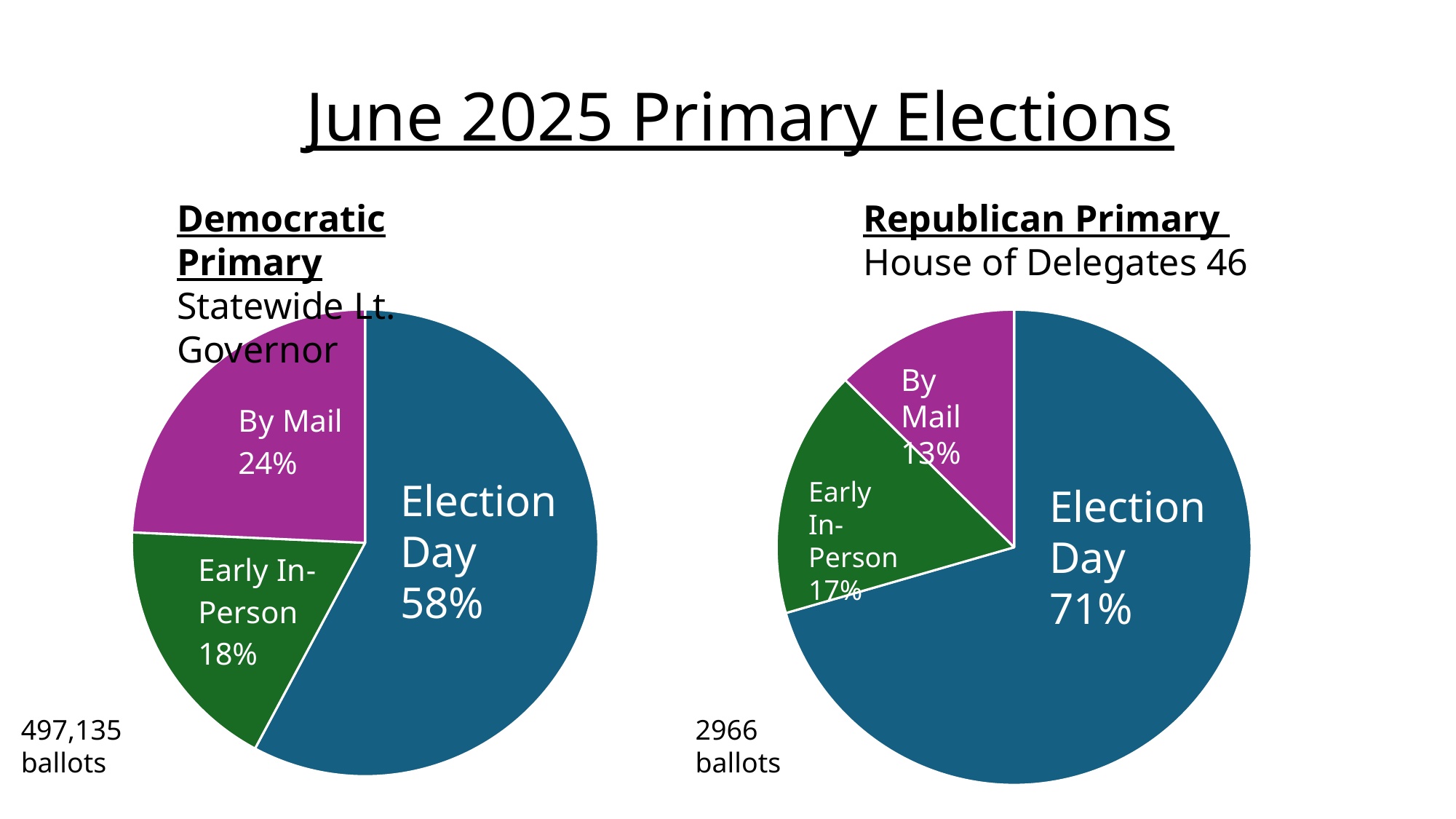
In the Democratic Primary pie chart, what share of ballots were cast By Mail? 24% In the Republican Primary pie chart, which voting method has the smallest share? By Mail What is the difference between the Election Day share in the Republican Primary chart and the Election Day share in the Democratic Primary chart? 13% In the Republican Primary pie chart, what share of ballots were cast Early In-Person? 17% In the Democratic Primary pie chart, what share of ballots were cast on Election Day? 58% In the Democratic Primary pie chart, which voting method has the smallest share? Early In-Person What type of chart is used for the Republican Primary? Pie chart In the Republican Primary pie chart, which voting method has the largest share? Election Day Which chart has the larger By Mail share, the Democratic Primary or the Republican Primary? Democratic Primary In the Democratic Primary pie chart, what is the difference between the By Mail share and the Early In-Person share? 6% How many slices does the Democratic Primary pie chart have? 3 In the Republican Primary pie chart, what share of ballots were cast By Mail? 13%